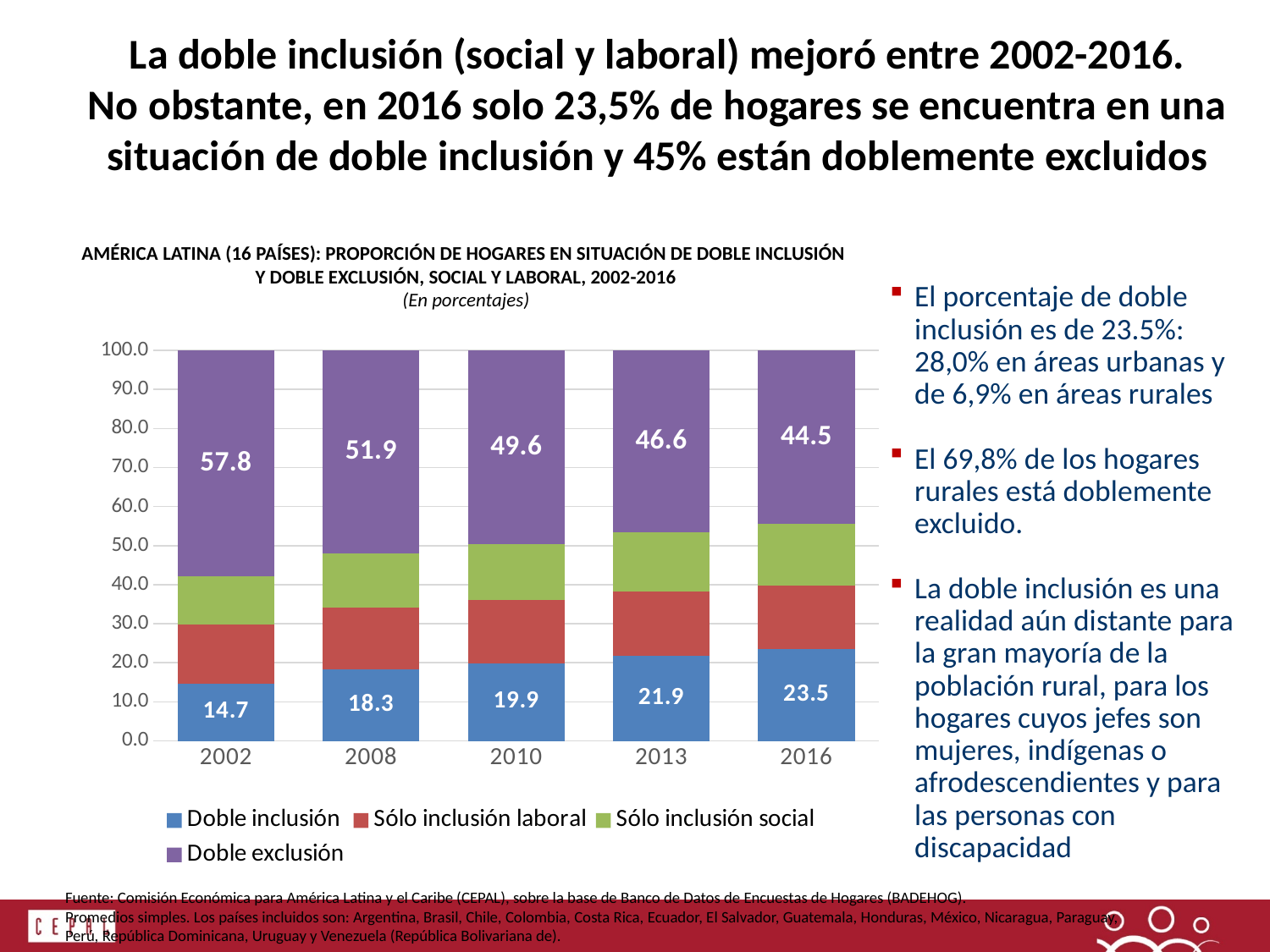
How many years are shown on the x axis? 5 What is the value for Doble exclusión in 2013? 46.6 How many series does the legend list? 4 What kind of chart is shown on the slide? Stacked bar chart Is the value for Doble exclusión in 2016 greater or less than 50? less What is the value for Doble inclusión in 2010? 19.9 Which is larger: Doble inclusión in 2008 or Doble inclusión in 2013? Doble inclusión in 2013 In which year is the Doble inclusión value lowest? 2002 What is the value for Doble exclusión in 2002? 57.8 What is the difference between the Doble exclusión values for 2002 and 2016? 13.3 What is the value for Doble inclusión in 2016? 23.5 In which year is the Doble exclusión value highest? 2002